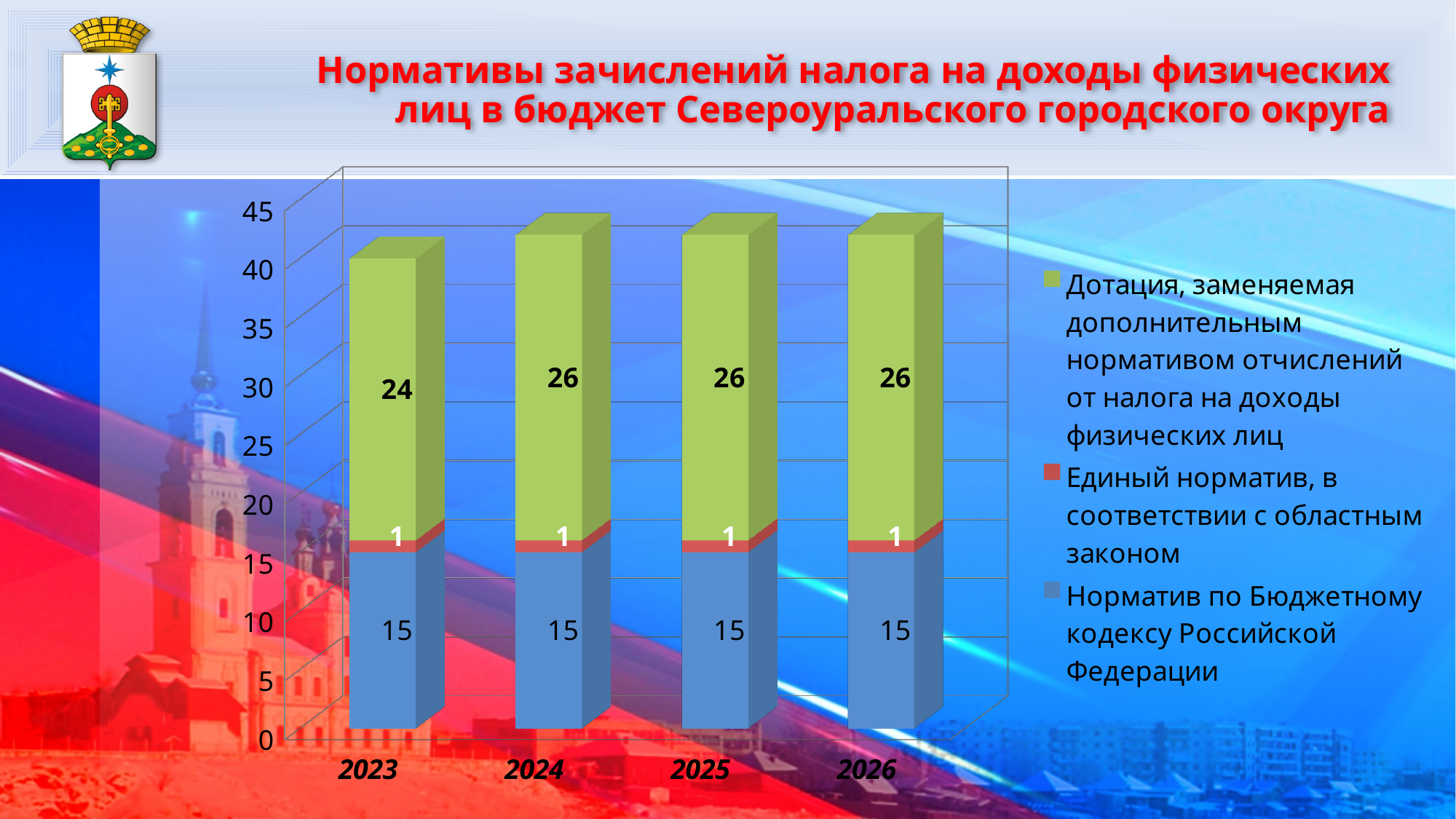
What type of chart is shown on the slide? stacked bar chart How many series does the chart legend list? 3 What is the total of the stacked bar for 2023? 40 What is the value of the Норматив по Бюджетному кодексу Российской Федерации segment for 2026? 15 What is the value of the green segment (Дотация, заменяемая дополнительным нормативом отчислений) for 2025? 26 What is the difference between the green segment values for 2024 and 2023? 2 Does the green segment value rise or fall from 2023 to 2024? rise Which year has the lowest total stacked bar? 2023 What is the total of the stacked bar for 2024? 42 How many years are shown on the x axis of the chart? 4 What is the value of the Единый норматив, в соответствии с областным законом segment for 2024? 1 What is the value of the green segment (Дотация, заменяемая дополнительным нормативом отчислений от налога на доходы физических лиц) for 2023? 24